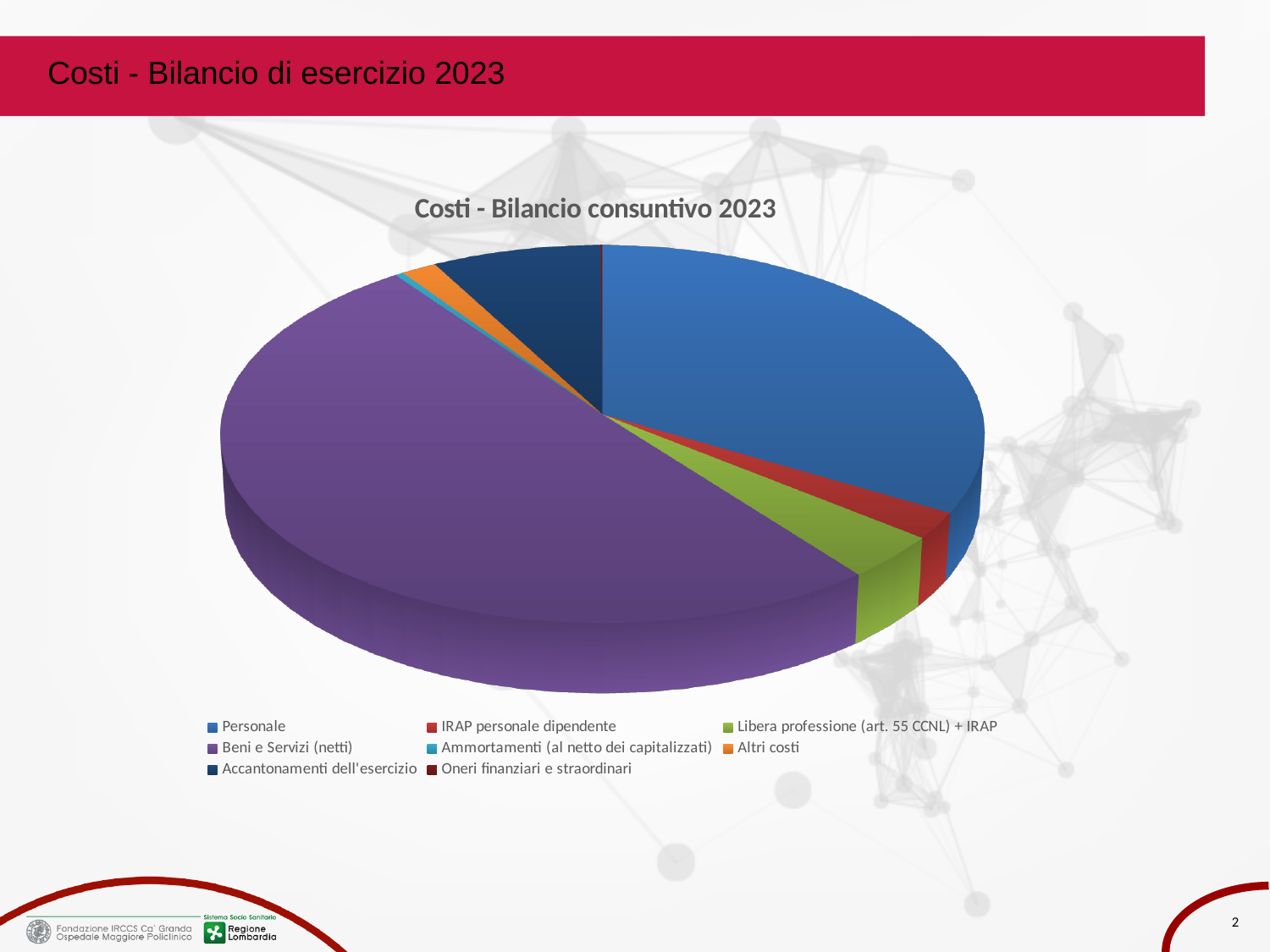
What is the title of the chart? Costi - Bilancio consuntivo 2023 Which slice is larger, Personale or Libera professione (art. 55 CCNL) + IRAP? Personale What colour represents Personale in the pie chart? blue How many categories does the legend of the pie chart list? 8 Which category has the largest slice of the pie? Beni e Servizi (netti) Which slice is larger, Beni e Servizi (netti) or Personale? Beni e Servizi (netti) Which slice is larger, Personale or Accantonamenti dell'esercizio? Personale What kind of chart is shown on the slide? pie chart